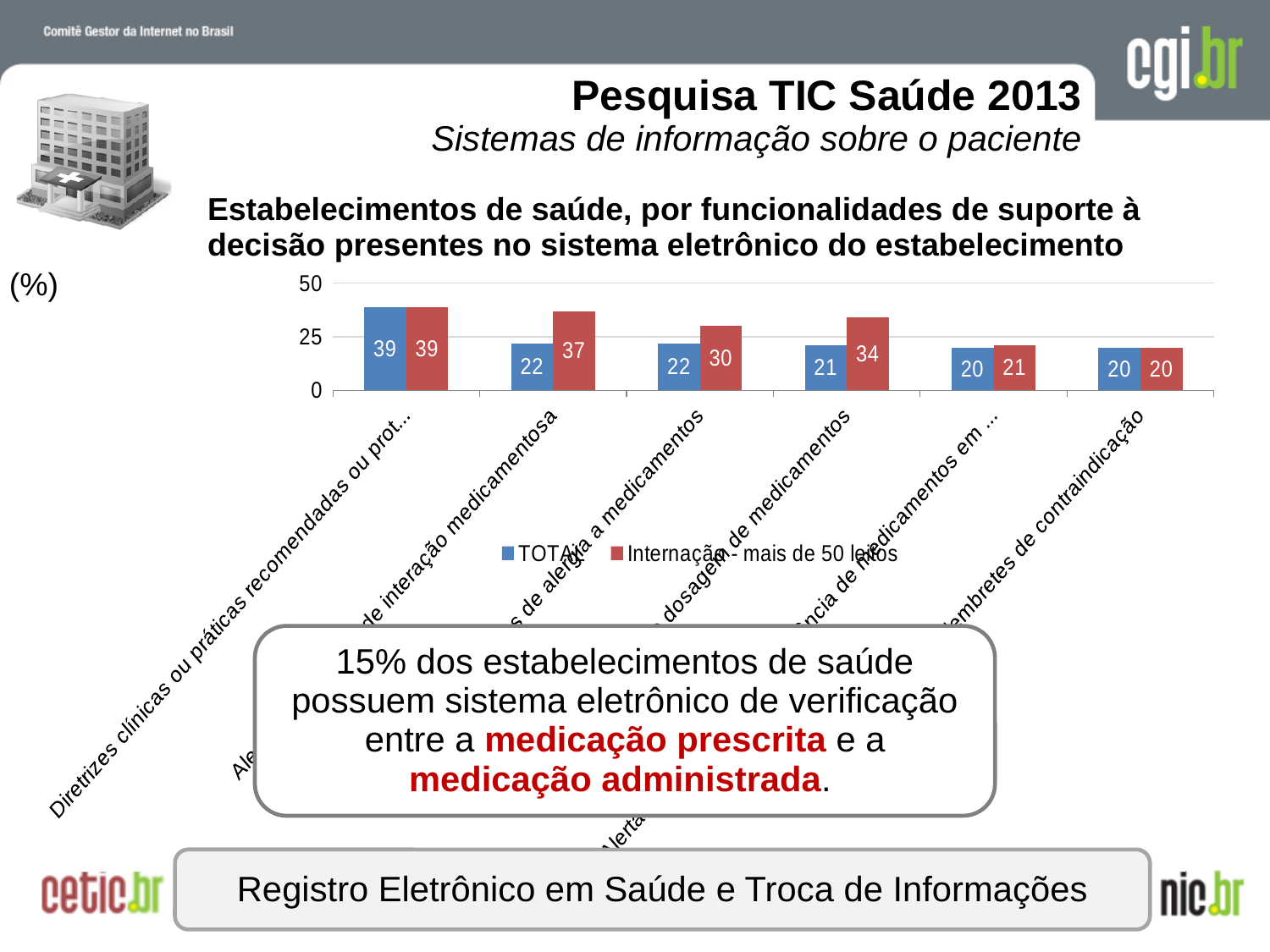
What type of chart is shown on the slide? bar chart Is the TOTAL value for the first category greater or less than 25? greater What is the difference between the 'Internação - mais de 50 leitos' value and the TOTAL value for the second category from the left? 15 How many series does the chart legend list? 2 What is the 'Internação - mais de 50 leitos' value for the second category from the left? 37 For the third category from the left, which is larger: the TOTAL value or the 'Internação - mais de 50 leitos' value? Internação - mais de 50 leitos What is the TOTAL value for the first (leftmost) category, 'Diretrizes clínicas ou práticas recomendadas...'? 39 What is the TOTAL value for the last (rightmost) category, '...embretes de contraindicação'? 20 How many categories are plotted along the x axis of the chart? 6 What is the 'Internação - mais de 50 leitos' value for the fourth category from the left? 34 Which category has the highest TOTAL value? Diretrizes clínicas ou práticas recomendadas ou prot... (the first category) Which colour represents the TOTAL series in the chart? blue